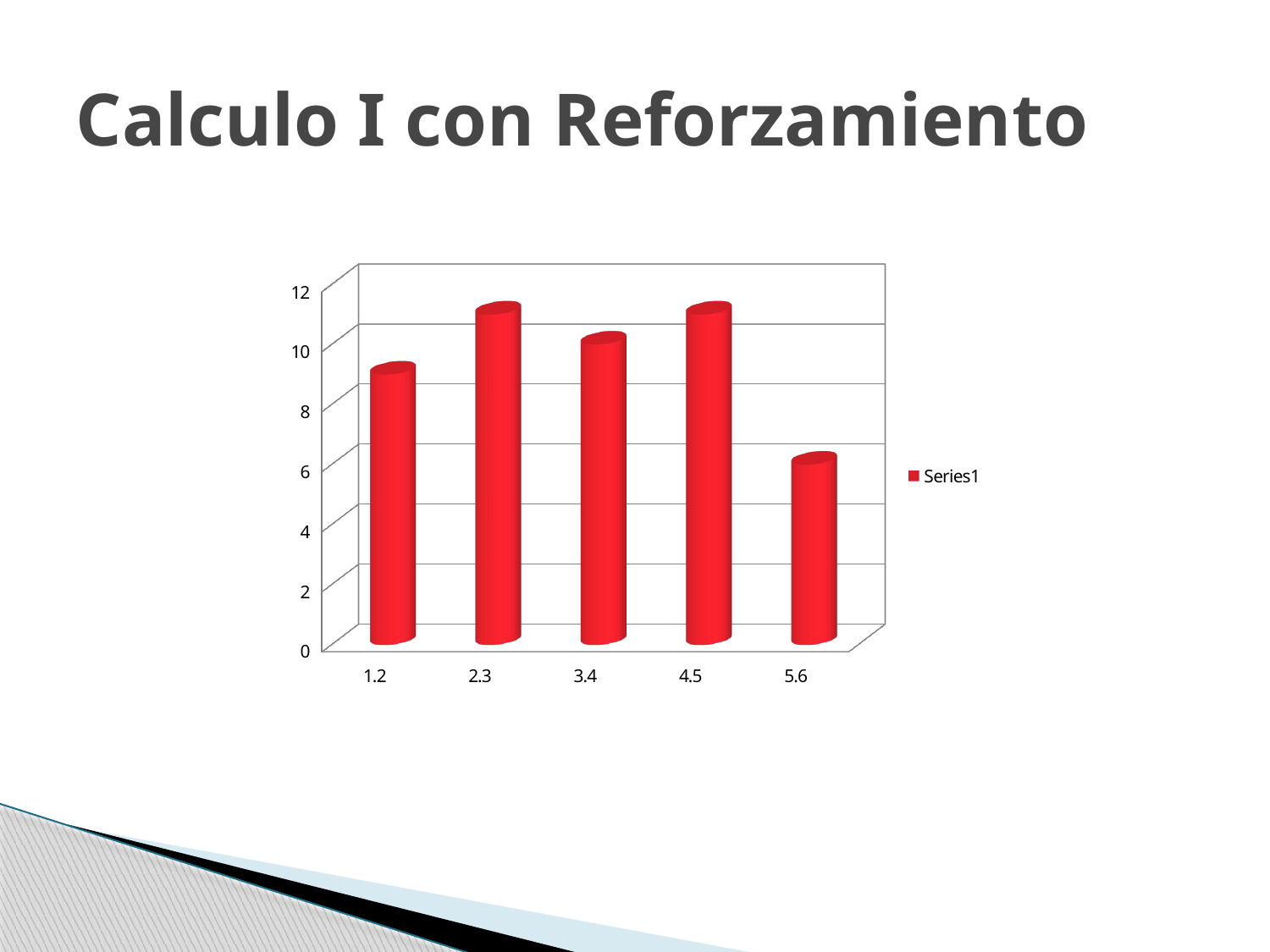
Is the value for category 5.6 greater or less than 8? less Which category has the lowest bar in the chart? 5.6 Which is larger, the value for category 1.2 or the value for category 5.6? 1.2 Is the value for category 3.4 greater or less than 8? greater Is the value for category 1.2 greater or less than 8? greater What colour are the bars in the chart? red How many series does the chart's legend list? 1 What kind of chart is shown on the slide? bar chart Which is larger, the value for category 2.3 or the value for category 1.2? 2.3 How many categories are shown on the x axis of the chart? 5 What is the name of the series shown in the chart's legend? Series1